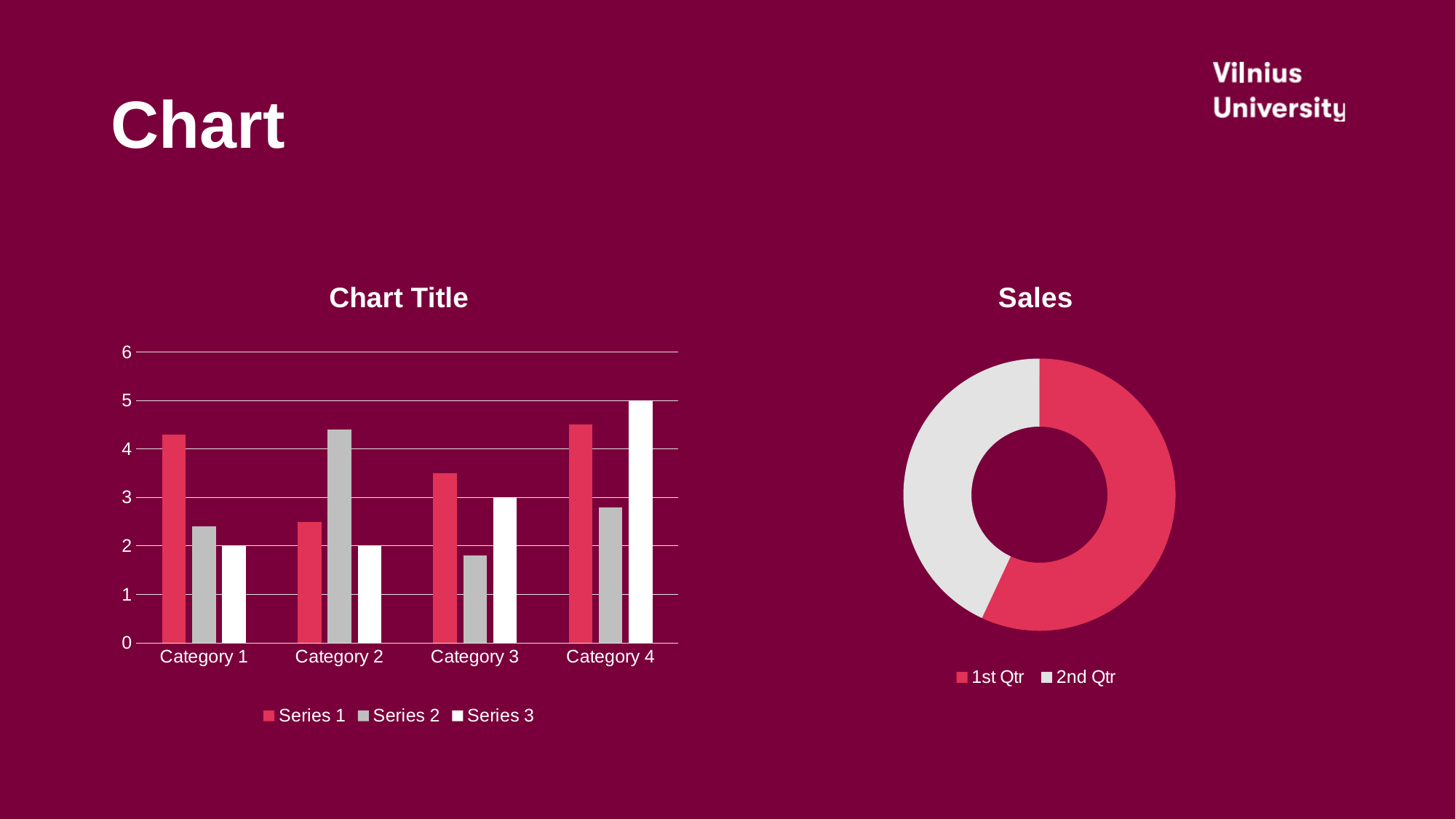
In the chart titled "Chart Title", what is the value of Series 3 for Category 3? 3 In the chart titled "Sales", which slice is larger: 1st Qtr or 2nd Qtr? 1st Qtr In the chart titled "Chart Title", what is the value of Series 3 for Category 4? 5 In the chart titled "Chart Title", how many categories are shown on the x axis? 4 In the chart titled "Chart Title", how many series does the legend list? 3 In the chart titled "Chart Title", which category has the lowest value for Series 2? Category 3 In the chart titled "Chart Title", for Category 2, which is larger: Series 1 or Series 2? Series 2 In the chart titled "Chart Title", which category has the highest value for Series 2? Category 2 What kind of chart is the chart titled "Sales"? doughnut chart What kind of chart is the chart titled "Chart Title"? bar chart In the chart titled "Chart Title", what is the difference between the Series 3 values for Category 4 and Category 1? 3 In the chart titled "Chart Title", is the value of Series 1 for Category 1 greater or less than 4? greater